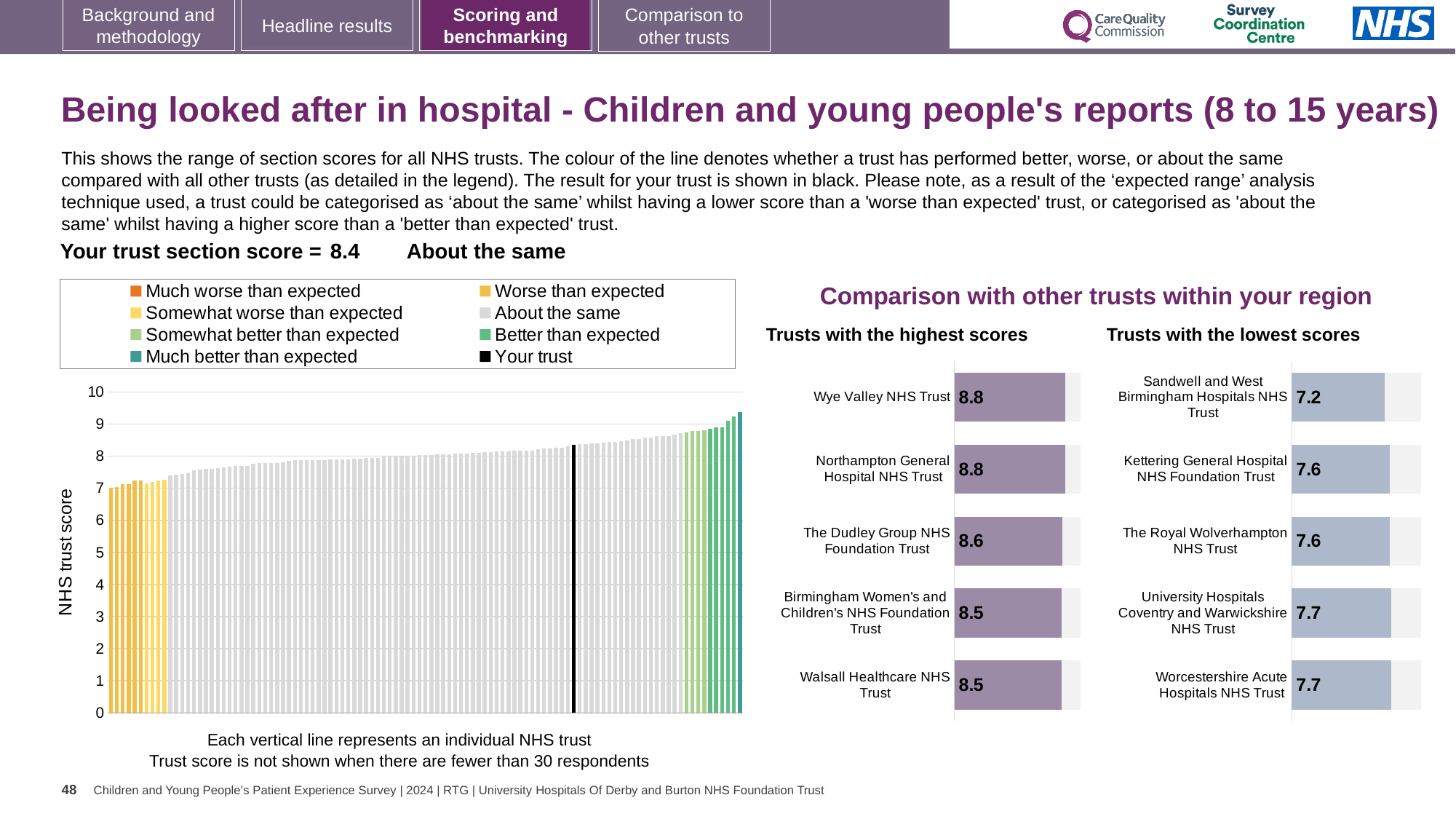
In the 'Trusts with the highest scores' chart, what is the score for Wye Valley NHS Trust? 8.8 In the 'Trusts with the lowest scores' chart, what is the difference between the scores of Worcestershire Acute Hospitals NHS Trust and Sandwell and West Birmingham Hospitals NHS Trust? 0.5 In the 'Trusts with the highest scores' chart, what is the difference between the scores of Wye Valley NHS Trust and The Dudley Group NHS Foundation Trust? 0.2 In the 'Trusts with the highest scores' chart, which has the higher score: Northampton General Hospital NHS Trust or Walsall Healthcare NHS Trust? Northampton General Hospital NHS Trust In the 'Trusts with the lowest scores' chart, what is the score for Sandwell and West Birmingham Hospitals NHS Trust? 7.2 How many entries does the legend above the main chart on the left list? 8 In the main chart on the left showing all NHS trusts, is the value of the black bar (your trust) greater or less than 8? greater In the 'Trusts with the highest scores' chart, what is the score for The Dudley Group NHS Foundation Trust? 8.6 In the 'Trusts with the lowest scores' chart, which trust has the lowest score? Sandwell and West Birmingham Hospitals NHS Trust How many trusts are listed in the 'Trusts with the lowest scores' chart? 5 In the main chart on the left showing all NHS trusts, is the value of the tallest bar greater or less than 9? greater What kind of chart is the main chart on the left showing all NHS trusts? bar chart